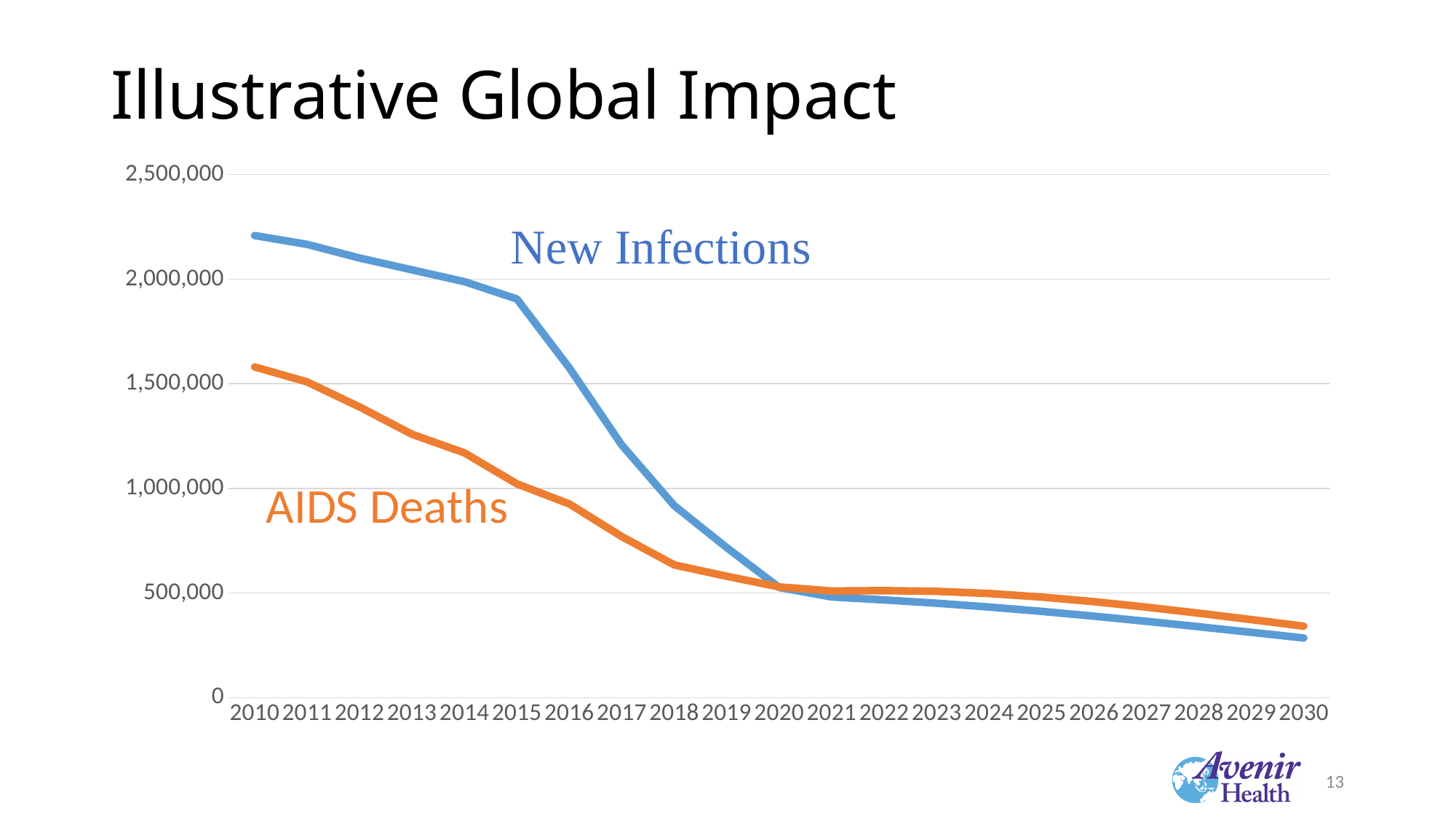
In which year are New Infections highest? 2010 What kind of chart is shown on the slide? Line chart What is the first year shown on the x axis? 2010 Is the value for New Infections in 2010 greater or less than 2,000,000? greater Which series is drawn in orange? AIDS Deaths How many data series are plotted on the chart? 2 Is the value for New Infections in 2018 greater or less than 1,000,000? less In which year are AIDS Deaths lowest? 2030 In 2010, which is larger: New Infections or AIDS Deaths? New Infections Is the value for AIDS Deaths in 2030 greater or less than 500,000? less Do New Infections rise or fall from 2010 to 2030? Fall How many years are shown along the x axis of the chart? 21